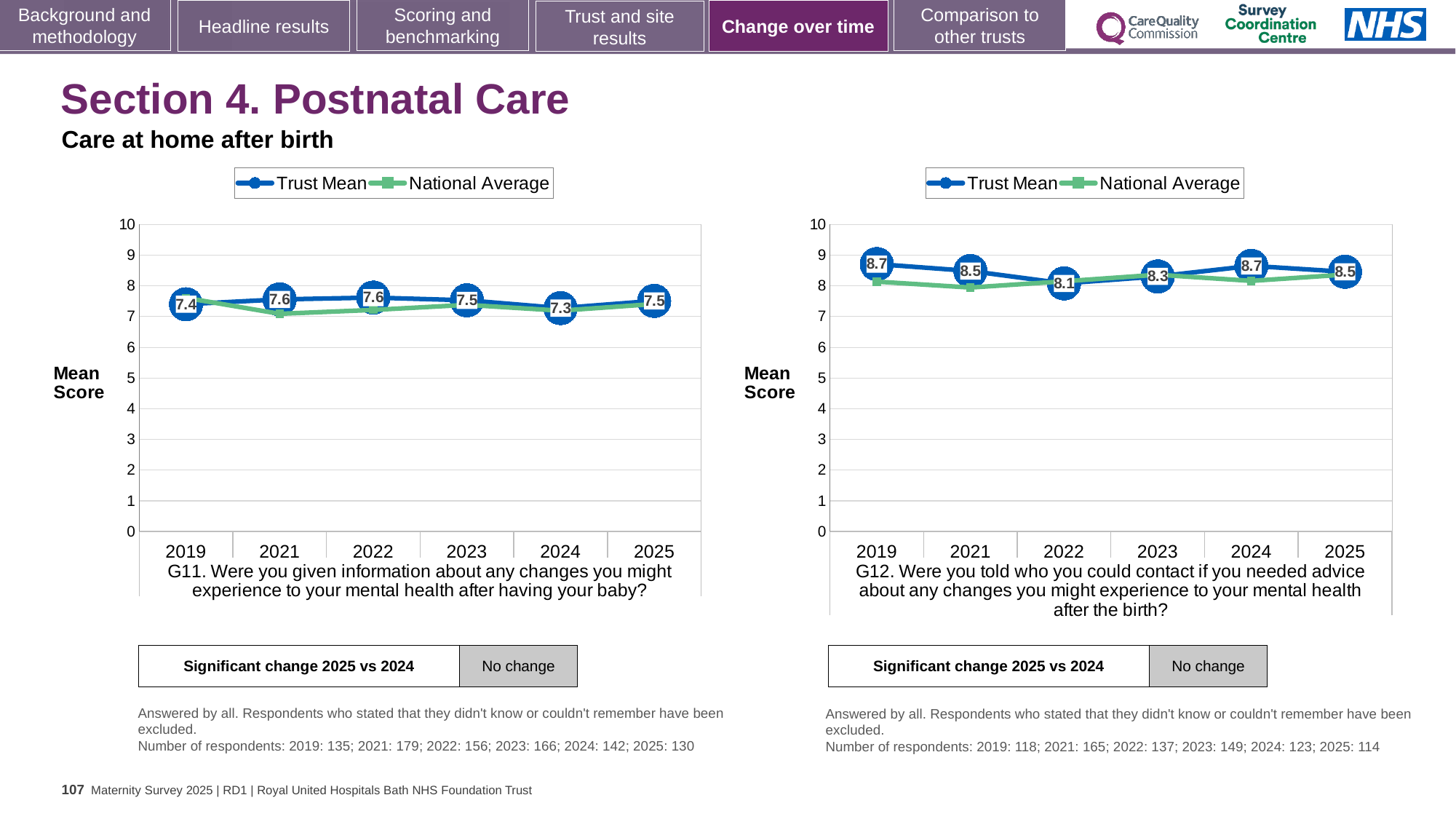
In the G11 chart on the left, what is the Trust Mean for 2024? 7.3 How many series does the legend of the G12 chart on the right list? 2 In the G11 chart on the left, what is the difference between the Trust Mean for 2021 and the Trust Mean for 2024? 0.3 In the G11 chart on the left, which year has the lowest Trust Mean? 2024 In the G12 chart on the right, is the Trust Mean higher in 2024 or in 2022? 2024 In the G12 chart on the right, which year has the lowest Trust Mean? 2022 In the G12 chart on the right, what is the difference between the Trust Mean for 2019 and the Trust Mean for 2022? 0.6 How many years are plotted on the x axis of the G11 chart on the left? 6 In the G12 chart on the right, what is the Trust Mean for 2022? 8.1 What kind of chart is the G11 chart on the left? Line chart In the G11 chart on the left, what is the Trust Mean for 2019? 7.4 In the G12 chart on the right, what is the Trust Mean for 2025? 8.5